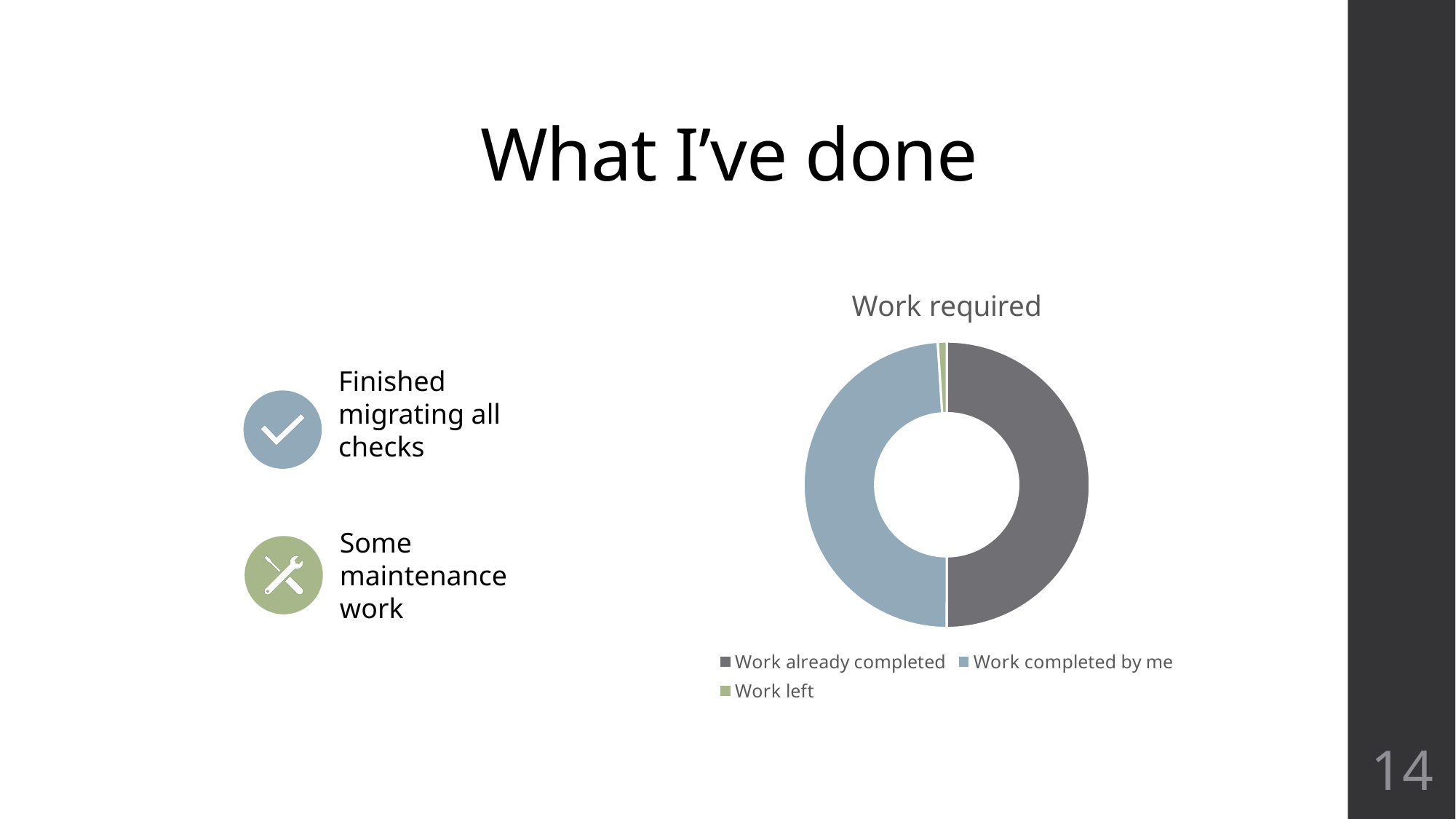
Which category has the smallest share of the chart? Work left What is the title of the chart? Work required Which is larger: the share for Work completed by me or the share for Work left? Work completed by me Which legend entry is shown in gray? Work already completed Which is larger: the share for Work already completed or the share for Work left? Work already completed What colour represents Work left in the chart? Green How many categories does the chart's legend list? 3 What kind of chart is shown on the slide? Doughnut chart